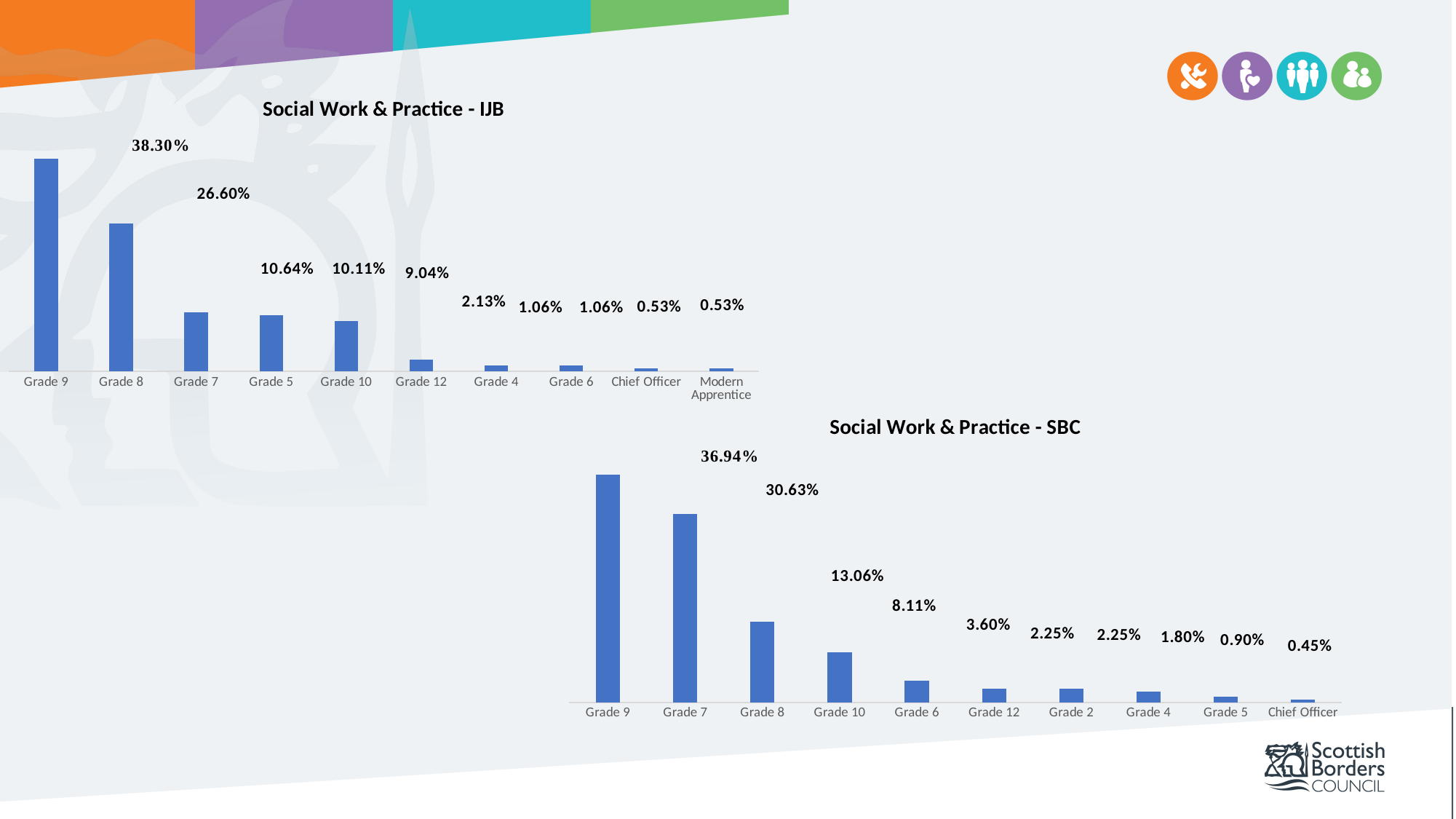
In the 'Social Work & Practice - SBC' chart, which category has the lowest value? Chief Officer In the 'Social Work & Practice - IJB' chart, what is the value for Grade 12? 2.13% In the 'Social Work & Practice - SBC' chart, what is the value for Grade 7? 30.63% In the 'Social Work & Practice - IJB' chart, what is the difference between the values for Grade 9 and Grade 8? 11.70% In the 'Social Work & Practice - SBC' chart, what is the value for Chief Officer? 0.45% In the 'Social Work & Practice - SBC' chart, which is larger, the value for Grade 6 or the value for Grade 12? Grade 6 In the 'Social Work & Practice - IJB' chart, what is the value for Grade 9? 38.30% In the 'Social Work & Practice - SBC' chart, which category has the highest value? Grade 9 What kind of chart is 'Social Work & Practice - SBC'? Bar chart In the 'Social Work & Practice - SBC' chart, what is the difference between the values for Grade 8 and Grade 10? 4.95% In the 'Social Work & Practice - IJB' chart, which category has the highest value? Grade 9 How many categories are shown in the 'Social Work & Practice - IJB' chart? 10